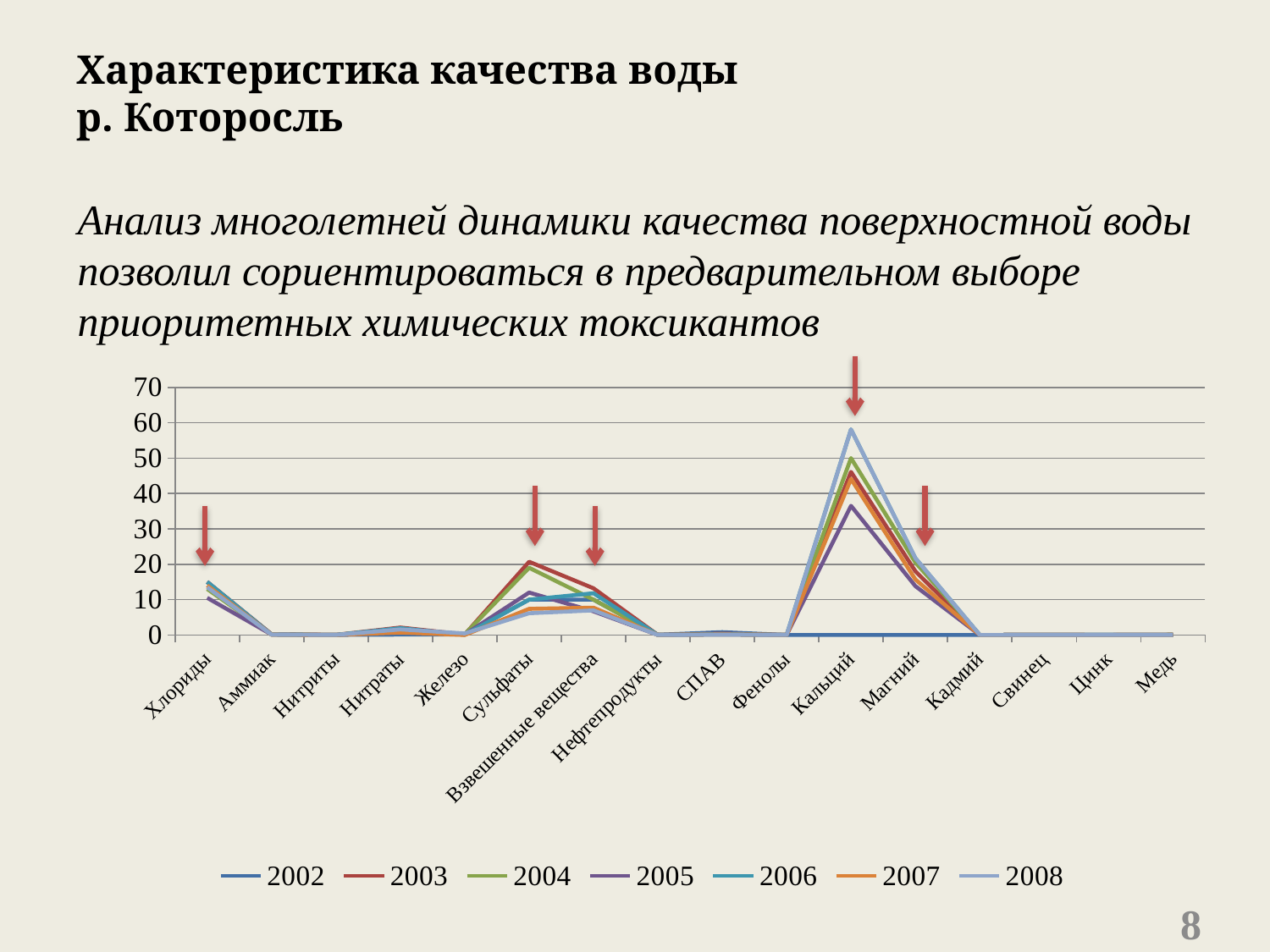
Which series has the higher value for Кальций, 2008 or 2005? 2008 Is the value for Кальций in 2008 greater or less than 50? greater What kind of chart is shown on the slide? line chart Which category has the highest values across the series? Кальций Is the value for Кальций in 2003 greater or less than 40? greater Is the value for Сульфаты in 2003 greater or less than 10? greater How many series does the legend list? 7 What is the highest value shown on the y axis? 70 How many categories are shown along the x axis? 16